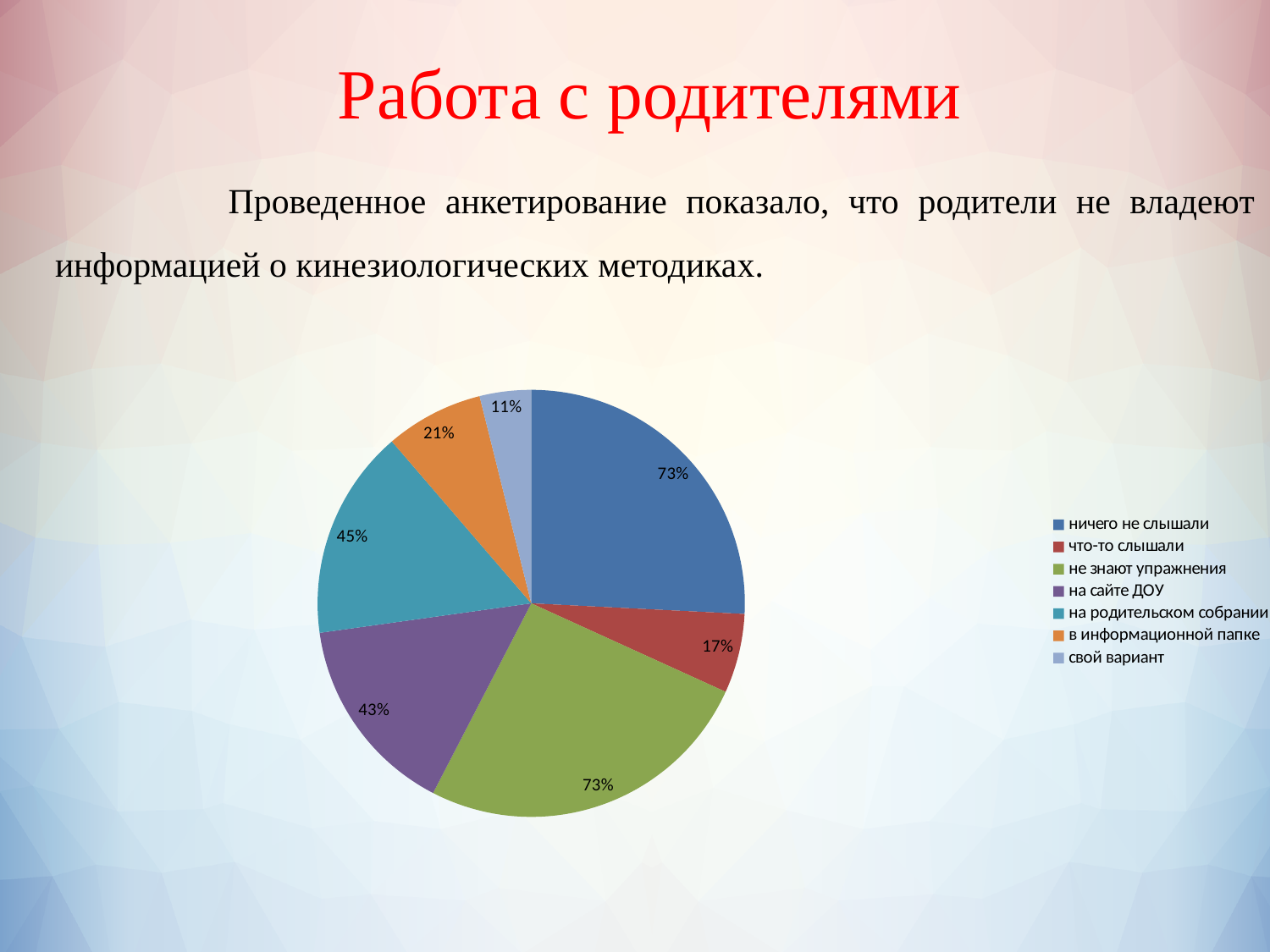
Which is larger: the value for 'на родительском собрании' or for 'на сайте ДОУ'? на родительском собрании What value is shown for the slice 'на сайте ДОУ'? 43% What value is shown for the slice 'что-то слышали'? 17% What type of chart is shown on the slide? pie chart What value is shown for the slice 'ничего не слышали'? 73% How many slices does the pie chart have? 7 How many entries does the legend of the pie chart list? 7 What is the difference between the values for 'ничего не слышали' and 'что-то слышали'? 56 percentage points What value is shown for the slice 'в информационной папке'? 21% What value is shown for the slice 'на родительском собрании'? 45% What colour is the slice for 'не знают упражнения'? green Which slice has the smallest value in the pie chart? свой вариант